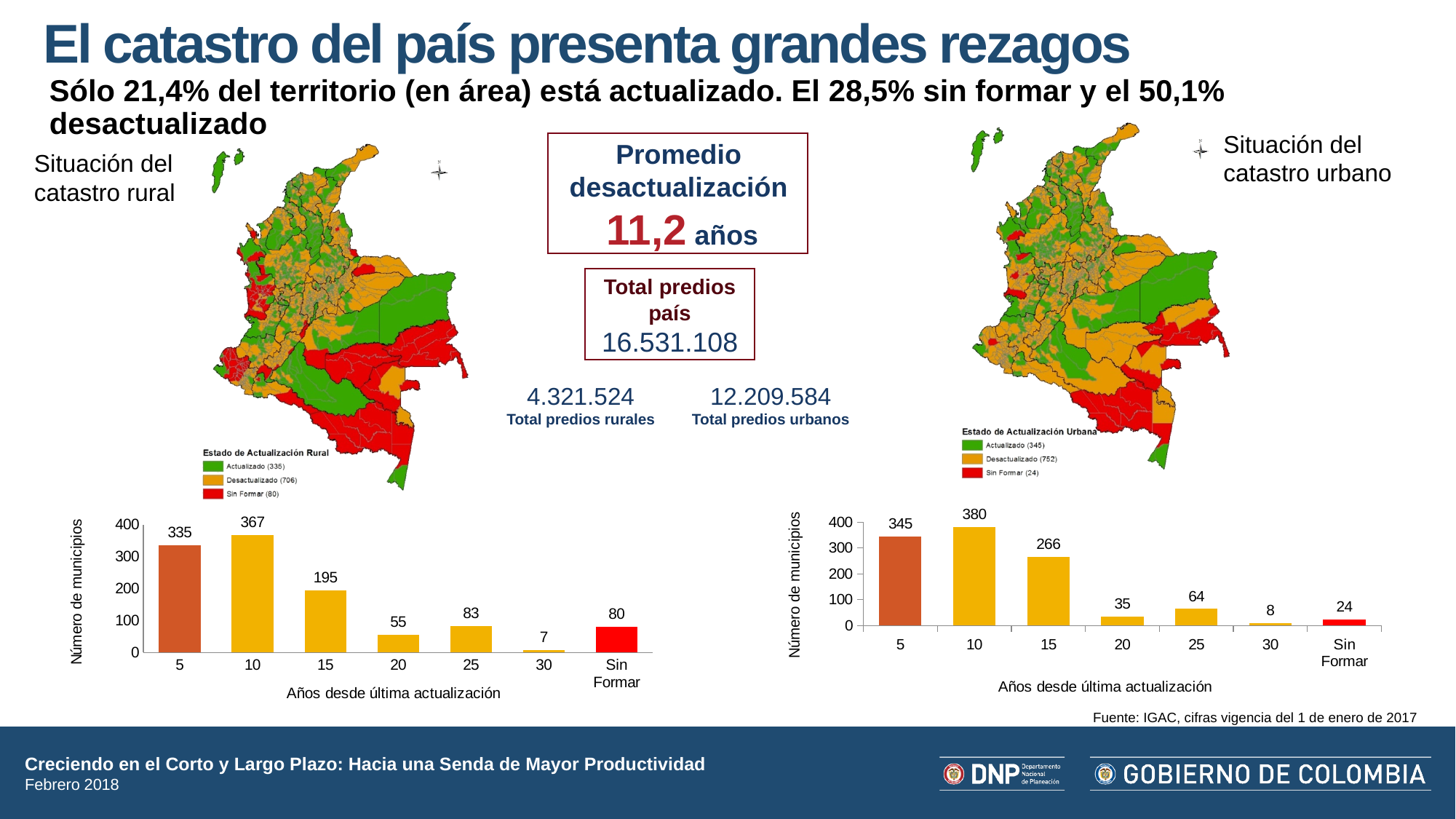
In the bar chart on the left of the slide, which category has the highest number of municipios? 10 In the bar chart on the right of the slide, what is the difference between the values for 10 and 5 años? 35 What kind of chart is shown at the bottom right of the slide? bar chart In the bar chart on the right of the slide, which category has the lowest number of municipios? 30 In the bar chart on the left of the slide, what is the number of municipios for 10 años desde última actualización? 367 What is the y-axis label of the bar chart on the left of the slide? Número de municipios In the bar chart on the right of the slide, what is the value for Sin Formar? 24 In the bar chart on the right of the slide, what is the number of municipios for 15 años desde última actualización? 266 How many categories are shown on the x axis of the bar chart on the left of the slide? 7 In the bar chart on the right of the slide, is the value for 20 años greater or less than 100? less In the bar chart on the left of the slide, what is the difference between the values for 5 and 15 años? 140 In the bar chart on the left of the slide, which is larger: the value for 25 años or the value for Sin Formar? 25 años